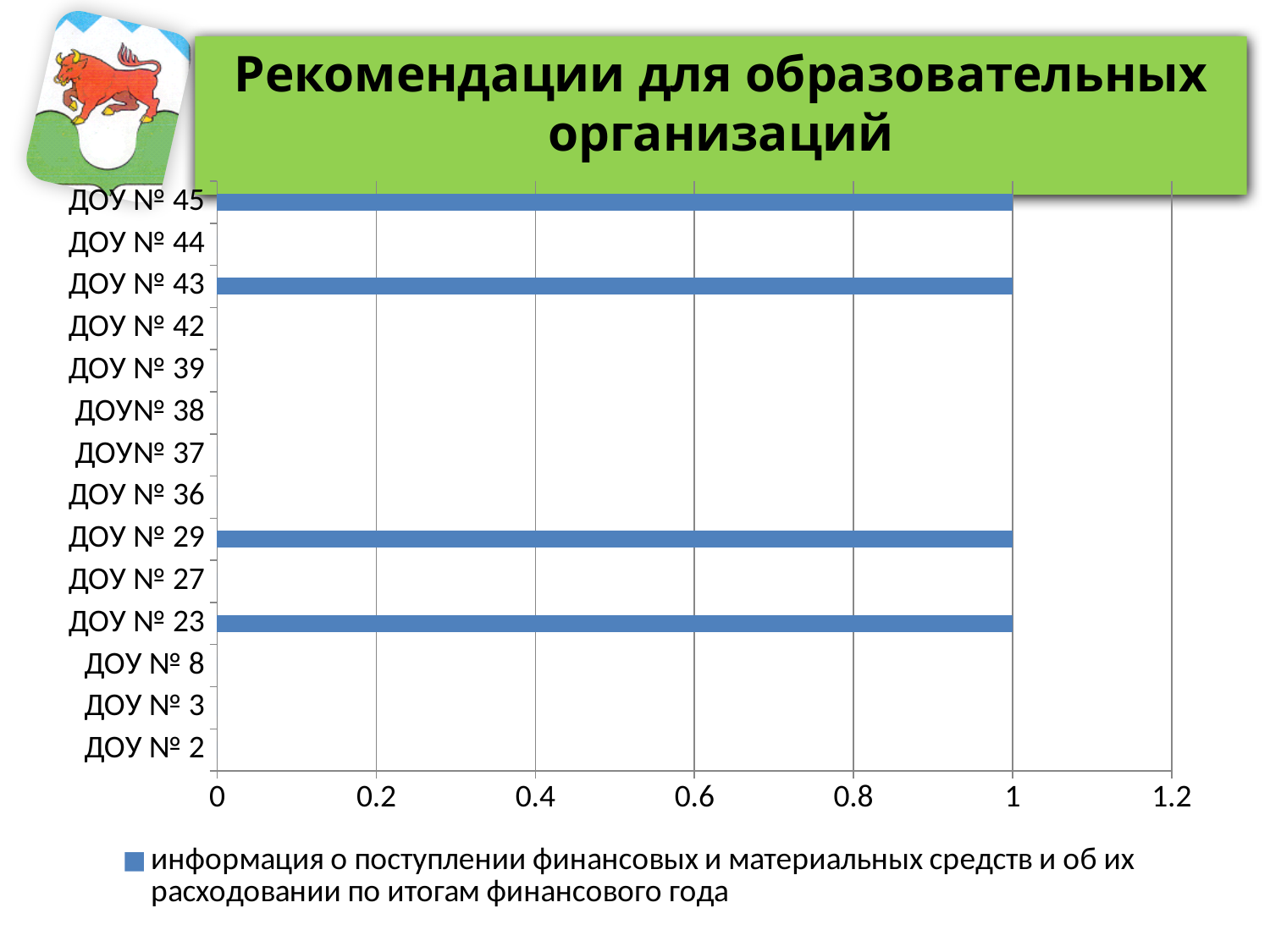
What kind of chart is shown on the slide? bar chart Is the value for ДОУ № 45 greater or less than 1.2? less What is the highest value shown on the horizontal axis of the chart? 1.2 How many categories are listed on the vertical axis of the chart? 14 What is the value for ДОУ № 43? 1 Is the value for ДОУ № 43 greater or less than 0.8? greater How many series does the chart legend list? 1 What is the value for ДОУ № 29? 1 What is the value for ДОУ № 45? 1 What is the difference between the value for ДОУ № 23 and the value for ДОУ № 45? 0 Which is larger, the value for ДОУ № 29 or the value for ДОУ № 27? ДОУ № 29 What is the value for ДОУ № 23? 1